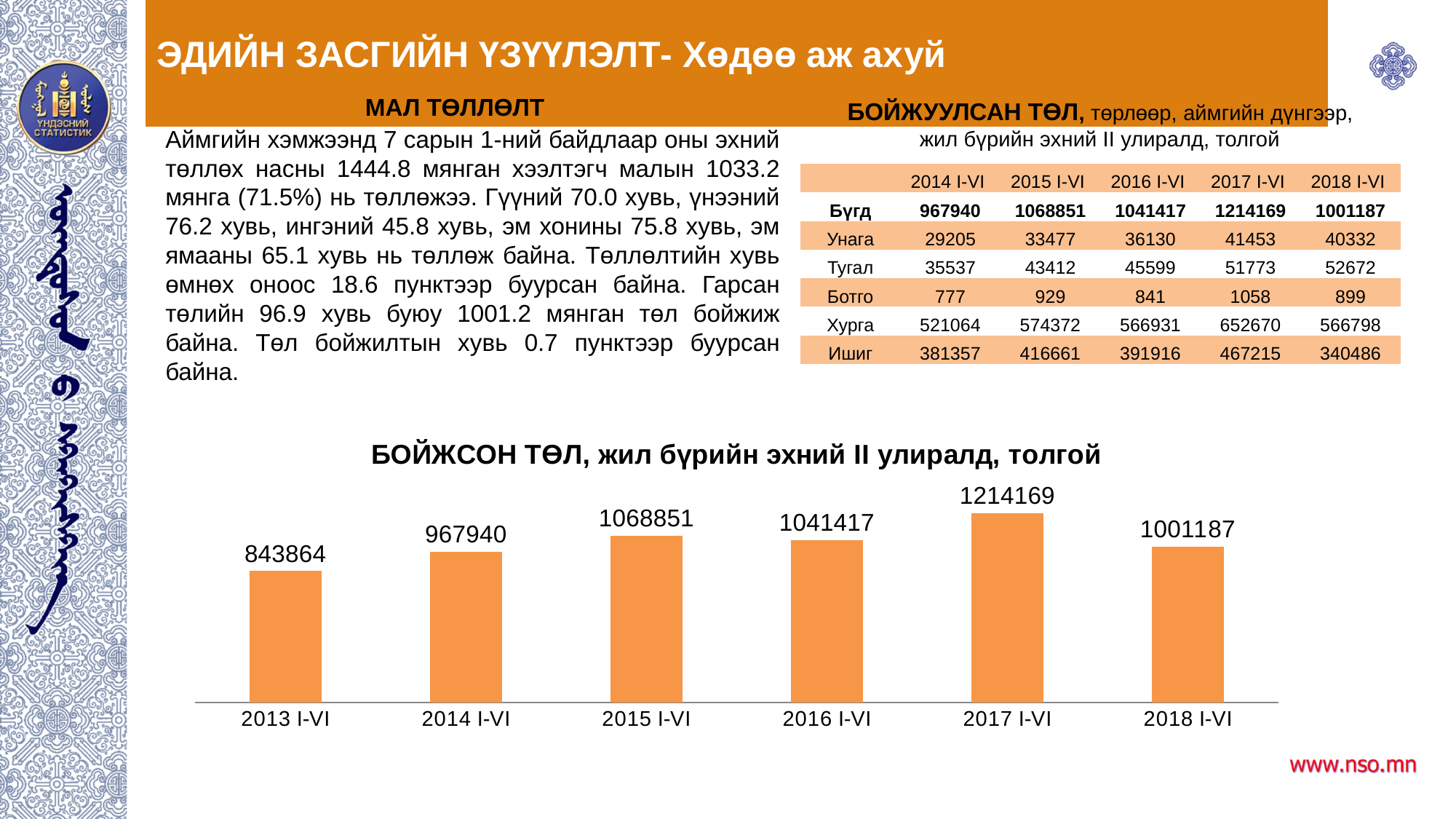
What is the title of the bar chart? БОЙЖСОН ТӨЛ, жил бүрийн эхний II улиралд, толгой What is the difference between the values for 2015 I-VI and 2014 I-VI in the bar chart? 100911 What is the value for 2013 I-VI in the bar chart? 843864 Which period has the highest value in the bar chart? 2017 I-VI Which period has the lowest value in the bar chart? 2013 I-VI Between 2013 I-VI and 2015 I-VI, do the values in the bar chart rise or fall? rise What is the value for 2018 I-VI in the bar chart? 1001187 What is the difference between the values for 2017 I-VI and 2013 I-VI in the bar chart? 370305 How many bars are shown in the bar chart? 6 What kind of chart is shown at the bottom of the slide? bar chart What is the value for 2017 I-VI in the bar chart? 1214169 Which is larger in the bar chart, the value for 2015 I-VI or 2016 I-VI? 2015 I-VI